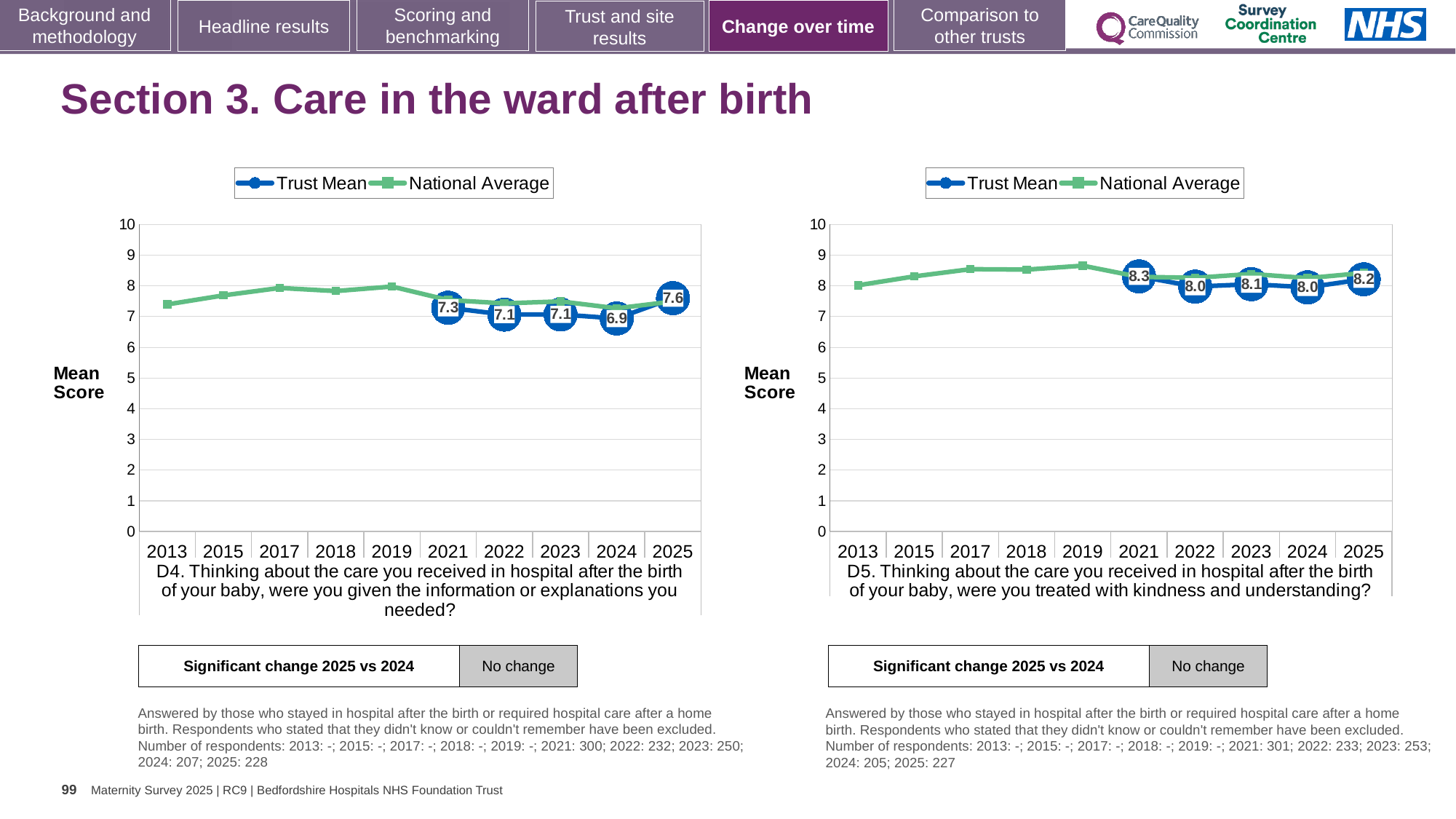
How many years are shown on the x axis of the D5 chart (right)? 10 In the D5 chart (right), what is the Trust Mean score for 2021? 8.3 In the D5 chart (right), what is the Trust Mean score for 2025? 8.2 In the D4 chart (left), which year has the lowest labelled Trust Mean score? 2024 In the D4 chart (left), is the National Average value for 2013 greater or less than 8? less In the D5 chart (right), which year has the highest labelled Trust Mean score? 2021 In the D4 chart (left), which year has the highest labelled Trust Mean score? 2025 How many series does the legend of the D4 chart (left) list? 2 In the D5 chart (right), is the Trust Mean score for 2022 larger or smaller than the score for 2021? smaller In the D4 chart (left), what is the Trust Mean score for 2024? 6.9 In the D4 chart (left), what is the Trust Mean score for 2025? 7.6 In the D4 chart (left), what is the difference between the Trust Mean scores for 2025 and 2024? 0.7